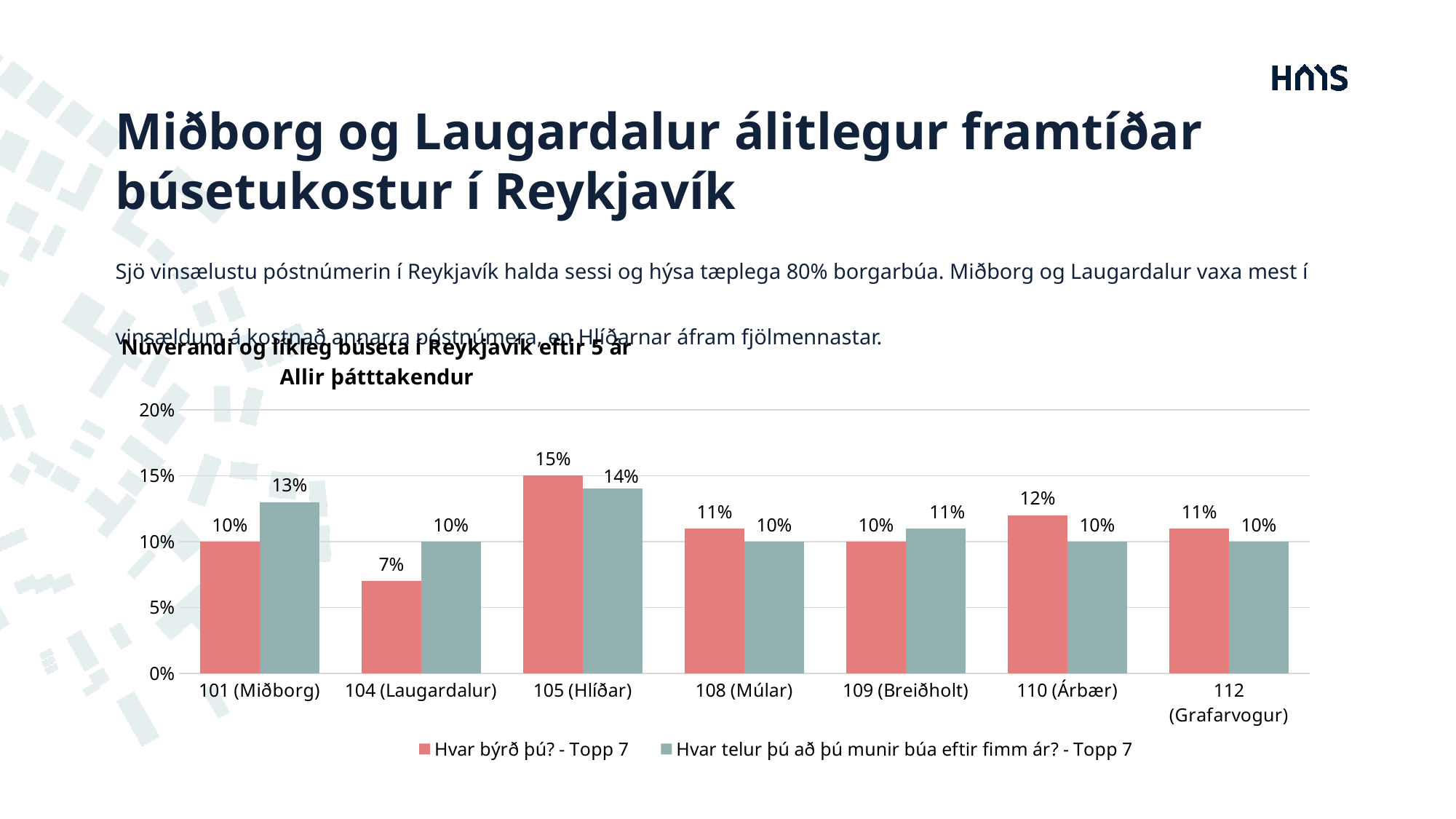
How many postcode categories are shown on the x axis? 7 How many series does the legend list? 2 What subtitle appears under the chart title? Allir þátttakendur What kind of chart is shown on the slide? Bar chart What is the value for 104 (Laugardalur) in the 'Hvar býrð þú? - Topp 7' series? 7% Is the value for 105 (Hlíðar) in the 'Hvar býrð þú? - Topp 7' series greater or less than 10%? greater Which category has the highest value in the 'Hvar býrð þú? - Topp 7' series? 105 (Hlíðar) What is the value for 109 (Breiðholt) in the 'Hvar telur þú að þú munir búa eftir fimm ár? - Topp 7' series? 11% Which category has the lowest value in the 'Hvar býrð þú? - Topp 7' series? 104 (Laugardalur) For 110 (Árbær), which series has the larger value? Hvar býrð þú? - Topp 7 What is the value for 101 (Miðborg) in the 'Hvar telur þú að þú munir búa eftir fimm ár? - Topp 7' series? 13% What is the difference between the two series for 101 (Miðborg)? 3%